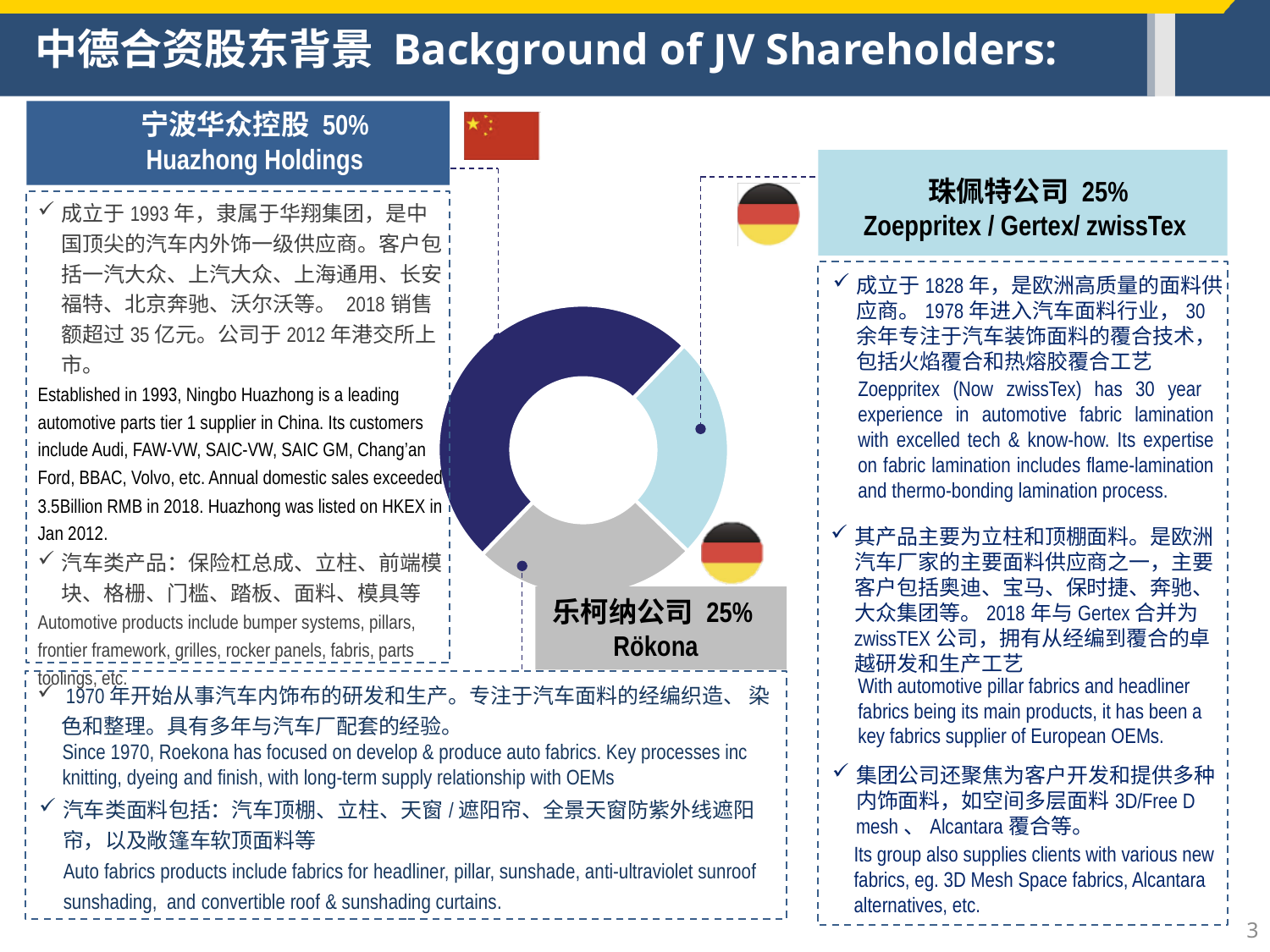
How many slices does the donut chart have? 3 What share of the JV does Zoeppritex / Gertex / zwissTex hold according to the chart? 25% What share of the JV does Huazhong Holdings hold according to the chart? 50% What kind of chart is shown in the centre of the slide? Donut (pie) chart Which two shareholders hold equal shares in the chart? Rökona and Zoeppritex / Gertex / zwissTex What colour is the slice representing Huazhong Holdings? Dark blue What share of the JV does Rökona hold according to the chart? 25% Which is larger, the share of Huazhong Holdings or the share of Rökona? Huazhong Holdings Is the share of Huazhong Holdings greater or less than 40%? greater What is the combined share of Rökona and Zoeppritex? 50% What is the difference between the share of Huazhong Holdings and the share of Zoeppritex? 25% Which shareholder has the largest slice of the donut chart? Huazhong Holdings